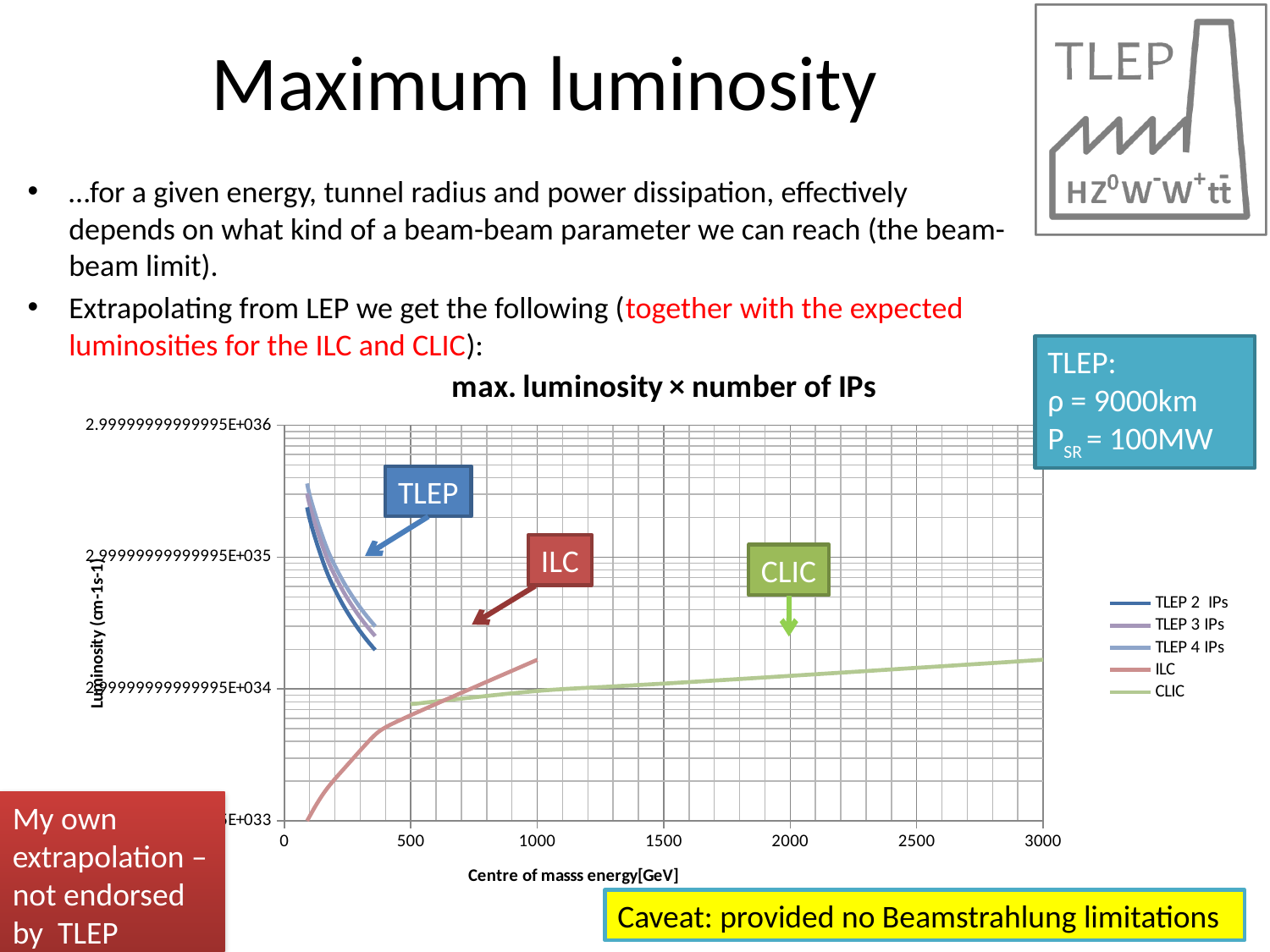
Does the ILC series rise or fall as centre of mass energy increases? rise Is the luminosity of the ILC series at 1000 GeV greater or less than 2.99999999999995E+034? greater How many series does the chart legend list? 5 Which series extends to the highest centre of mass energy on the chart? CLIC What is the title of the chart? max. luminosity × number of IPs What kind of chart is shown on the slide? line chart What is the label of the x axis of the chart? Centre of masss energy[GeV] What is the highest centre of mass energy value shown on the x axis? 3000 Does the TLEP 2 IPs series rise or fall as centre of mass energy increases? fall At a centre of mass energy of 200 GeV, which series has the higher luminosity, TLEP 4 IPs or TLEP 2 IPs? TLEP 4 IPs At a centre of mass energy of 1000 GeV, which series has the higher luminosity, ILC or CLIC? ILC Does the CLIC series rise or fall as centre of mass energy increases? rise